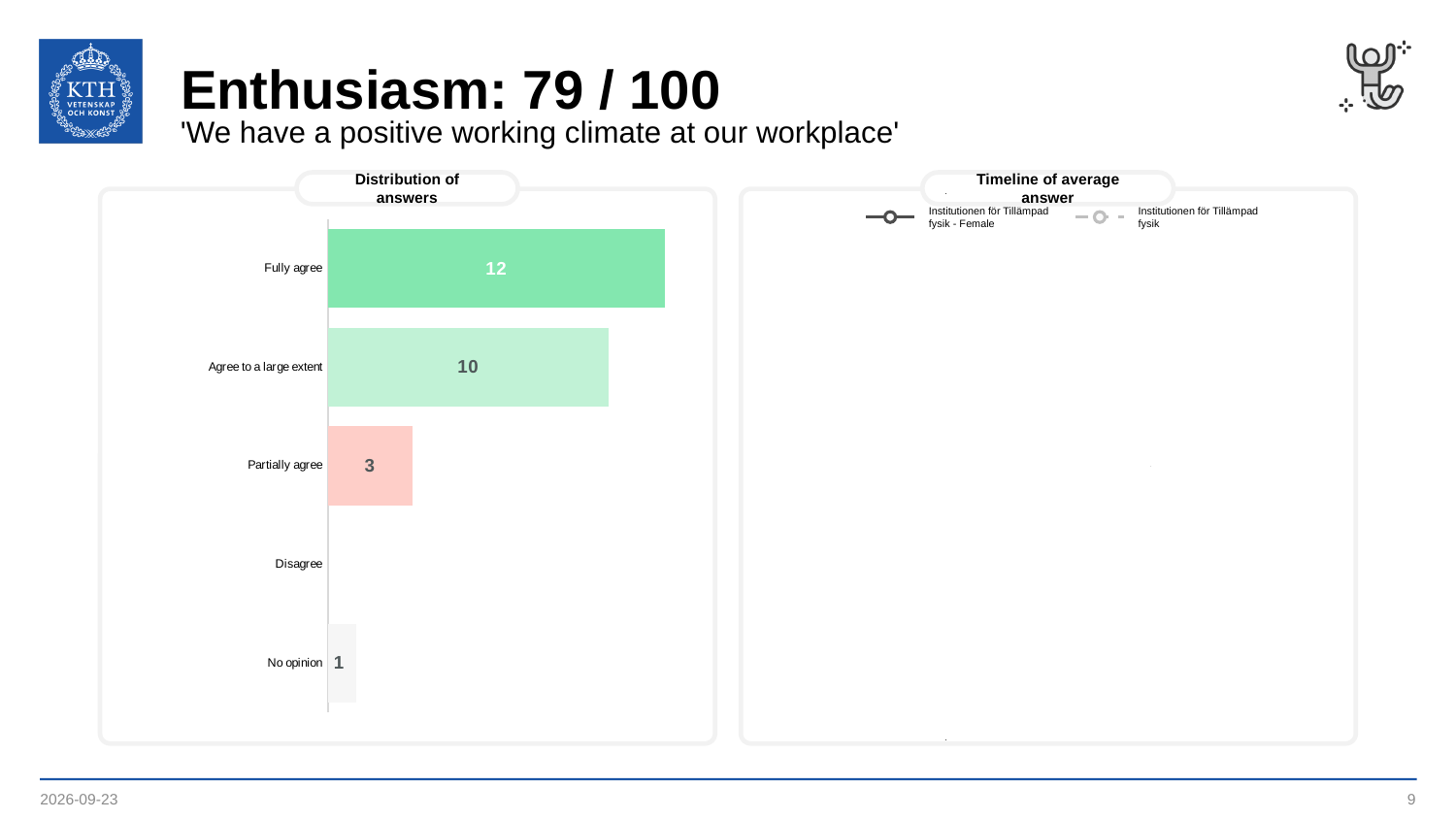
What kind of chart is the 'Distribution of answers' chart? Bar chart In the 'Distribution of answers' chart, what is the value for 'Partially agree'? 3 What is the title of the chart on the left side of the slide? Distribution of answers In the 'Distribution of answers' chart, what is the difference between 'Fully agree' and 'Agree to a large extent'? 2 In the 'Distribution of answers' chart, what is the value for 'No opinion'? 1 In the 'Distribution of answers' chart, what is the value for 'Fully agree'? 12 In the 'Distribution of answers' chart, which is larger: 'Partially agree' or 'No opinion'? Partially agree In the 'Distribution of answers' chart, what is the difference between 'Agree to a large extent' and 'Partially agree'? 7 In the 'Distribution of answers' chart, what is the value for 'Agree to a large extent'? 10 How many series does the legend of the 'Timeline of average answer' chart list? 2 In the 'Distribution of answers' chart, which category has the highest value? Fully agree How many categories are shown in the 'Distribution of answers' chart? 5